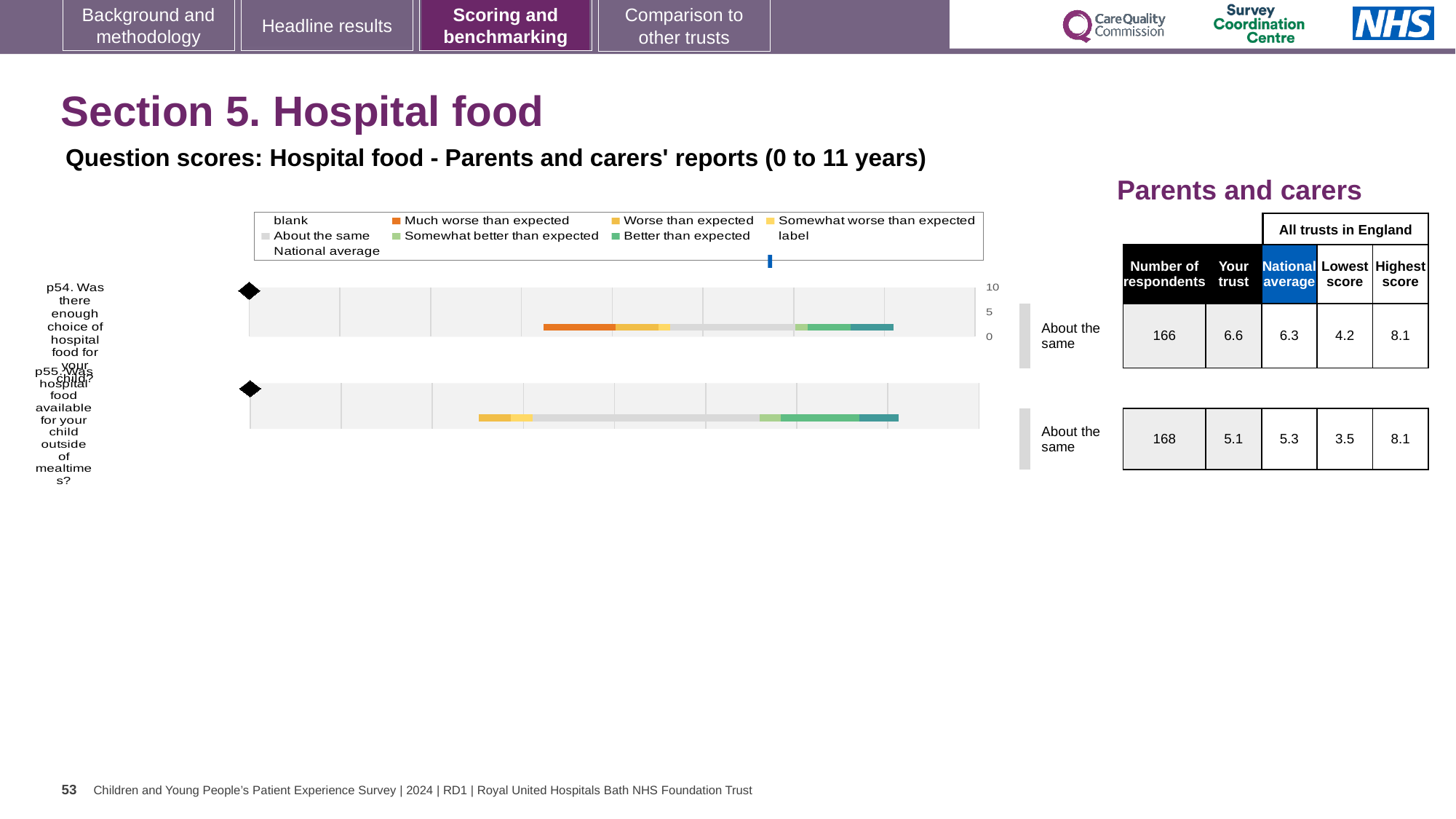
What is the maximum value shown on the chart's score axis? 10 What is the difference between the 'Your trust' scores for p54 (6.6) and p55 (5.1)? 1.5 According to the table beside the chart, what is the national average for p55 (hospital food available outside of mealtimes)? 5.3 Which benchmark category is the trust's result for p55 placed in? About the same How many survey questions (categories) are plotted in the chart? 2 Which colour does the legend use for 'Much worse than expected'? orange What is the highest score among all trusts in England for p54? 8.1 Which question has the higher 'Your trust' score, p54 or p55? p54 What kind of chart is shown on the slide? bar chart How many respondents answered p55? 168 For p54, is the 'Your trust' score (6.6) higher or lower than the national average (6.3)? higher According to the table beside the chart, what is the 'Your trust' score for p54 (enough choice of hospital food)? 6.6